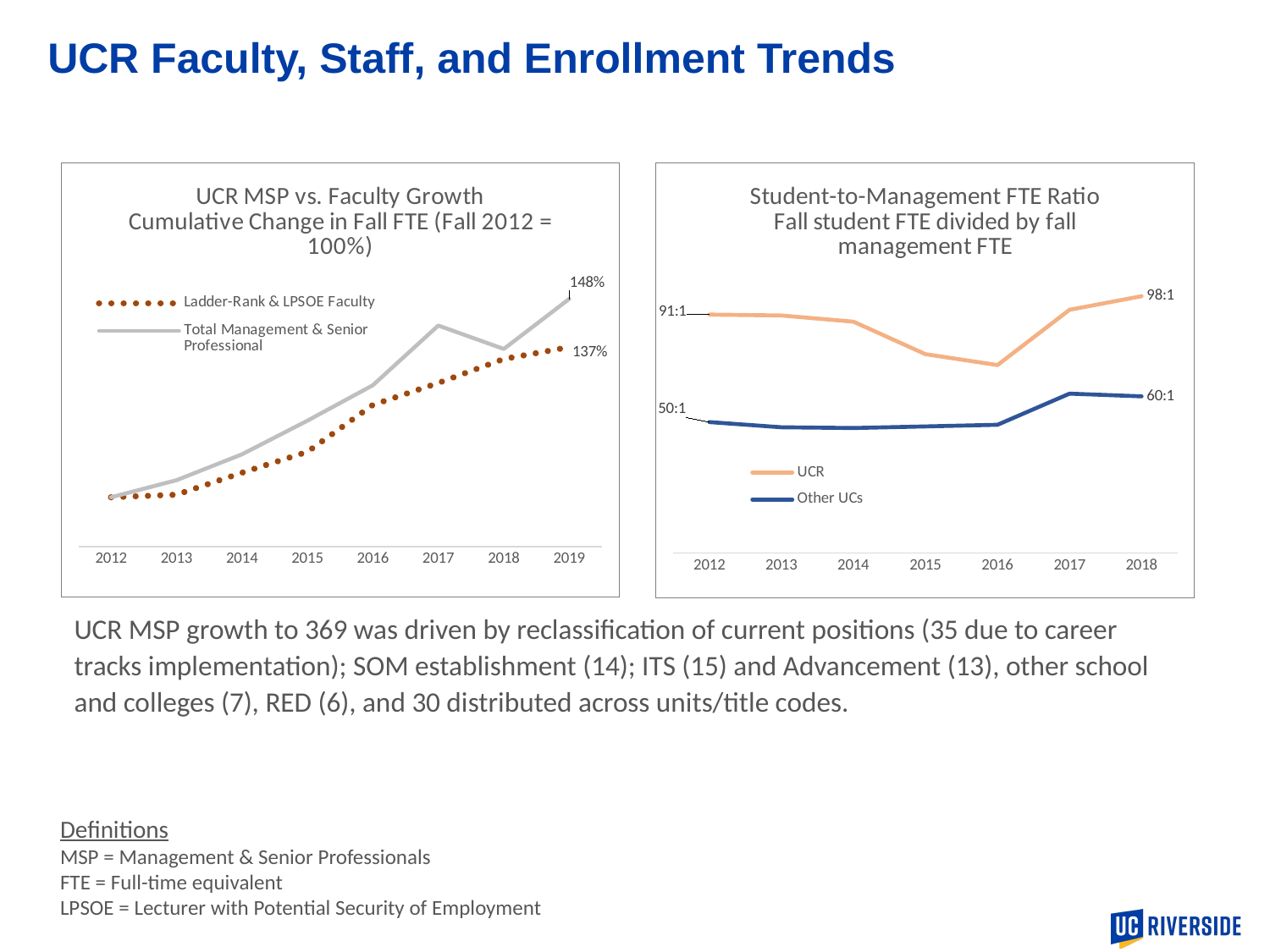
In the right chart (Student-to-Management FTE Ratio), what is the UCR value in 2018? 98:1 In the left chart (UCR MSP vs. Faculty Growth), what is the 2019 value for Total Management & Senior Professional? 148% In the left chart (UCR MSP vs. Faculty Growth), does the Ladder-Rank & LPSOE Faculty line rise or fall from 2012 to 2019? Rise What kind of chart is the Student-to-Management FTE Ratio chart on the right? Line chart In the right chart (Student-to-Management FTE Ratio), how many series does the legend list? 2 In the right chart (Student-to-Management FTE Ratio), what is the Other UCs value in 2012? 50:1 In the left chart (UCR MSP vs. Faculty Growth), by how many percentage points does the 2019 Total Management & Senior Professional value exceed the 2019 Ladder-Rank & LPSOE Faculty value? 11 percentage points In the right chart (Student-to-Management FTE Ratio), which series is shown in orange? UCR In the left chart (UCR MSP vs. Faculty Growth), which series is higher in 2019, Ladder-Rank & LPSOE Faculty or Total Management & Senior Professional? Total Management & Senior Professional In the right chart (Student-to-Management FTE Ratio), what is the UCR value in 2012? 91:1 In the left chart (UCR MSP vs. Faculty Growth), what is the 2019 value for Ladder-Rank & LPSOE Faculty? 137% In the left chart (UCR MSP vs. Faculty Growth), how many years are shown on the x axis? 8